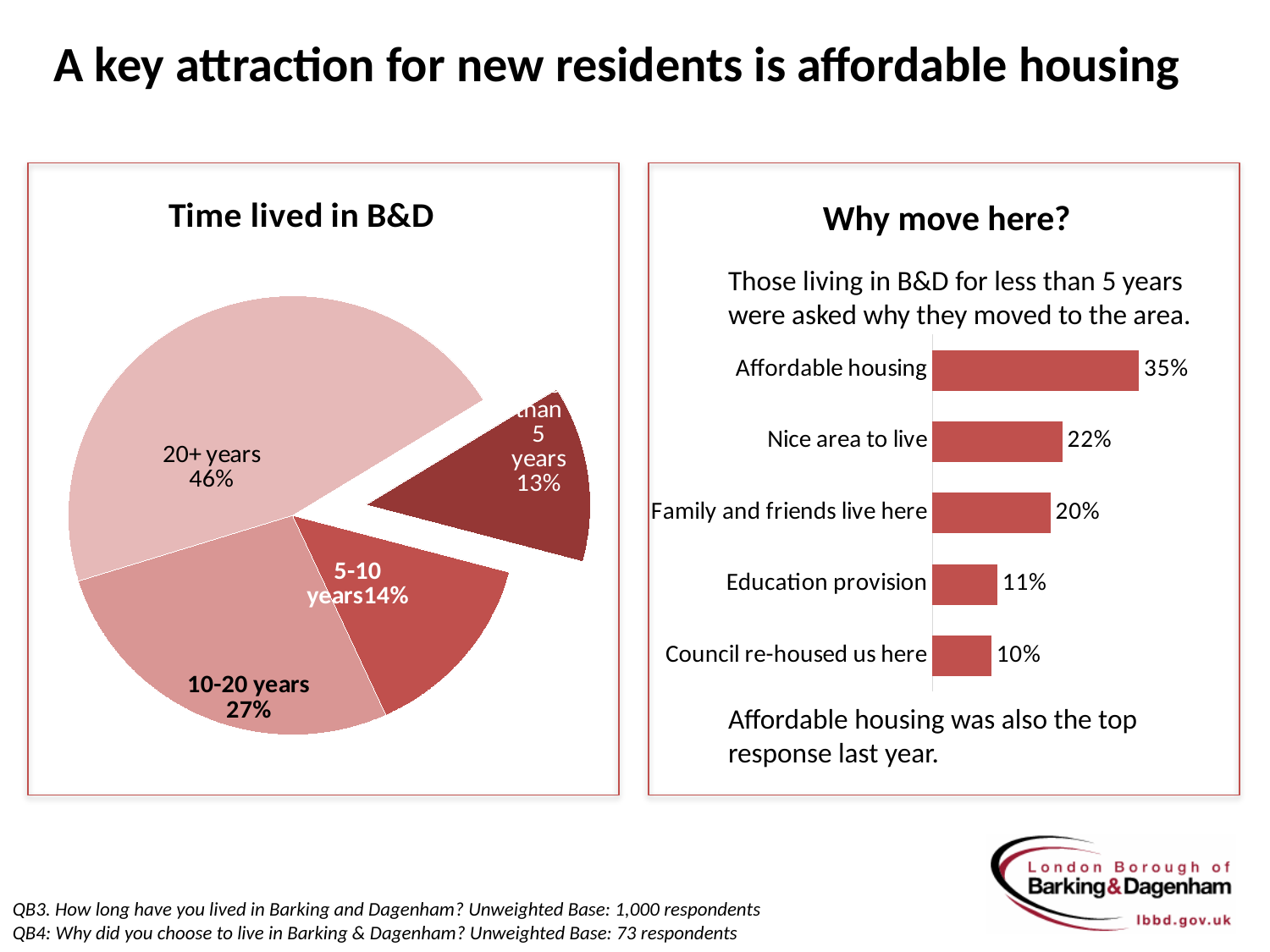
In the 'Time lived in B&D' pie chart, how many slices are there? 4 In the 'Time lived in B&D' pie chart, what percentage is shown on the exploded (pulled-out) slice? 13% In the 'Why move here?' chart, which reason has the lowest percentage? Council re-housed us here In the 'Why move here?' chart, what percentage is shown for 'Education provision'? 11% In the 'Time lived in B&D' pie chart, what percentage is shown for 5-10 years? 14% In the 'Time lived in B&D' pie chart, which category has the largest share? 20+ years What type of chart is 'Time lived in B&D'? Pie chart In the 'Time lived in B&D' pie chart, what share of respondents have lived in B&D for 20+ years? 46% In the 'Why move here?' chart, what is the difference between 'Nice area to live' and 'Family and friends live here'? 2% In the 'Time lived in B&D' pie chart, what percentage is shown for 10-20 years? 27% In the 'Time lived in B&D' pie chart, what is the difference between the 20+ years share and the 10-20 years share? 19% In the 'Why move here?' chart, what percentage gave 'Affordable housing' as their reason? 35%